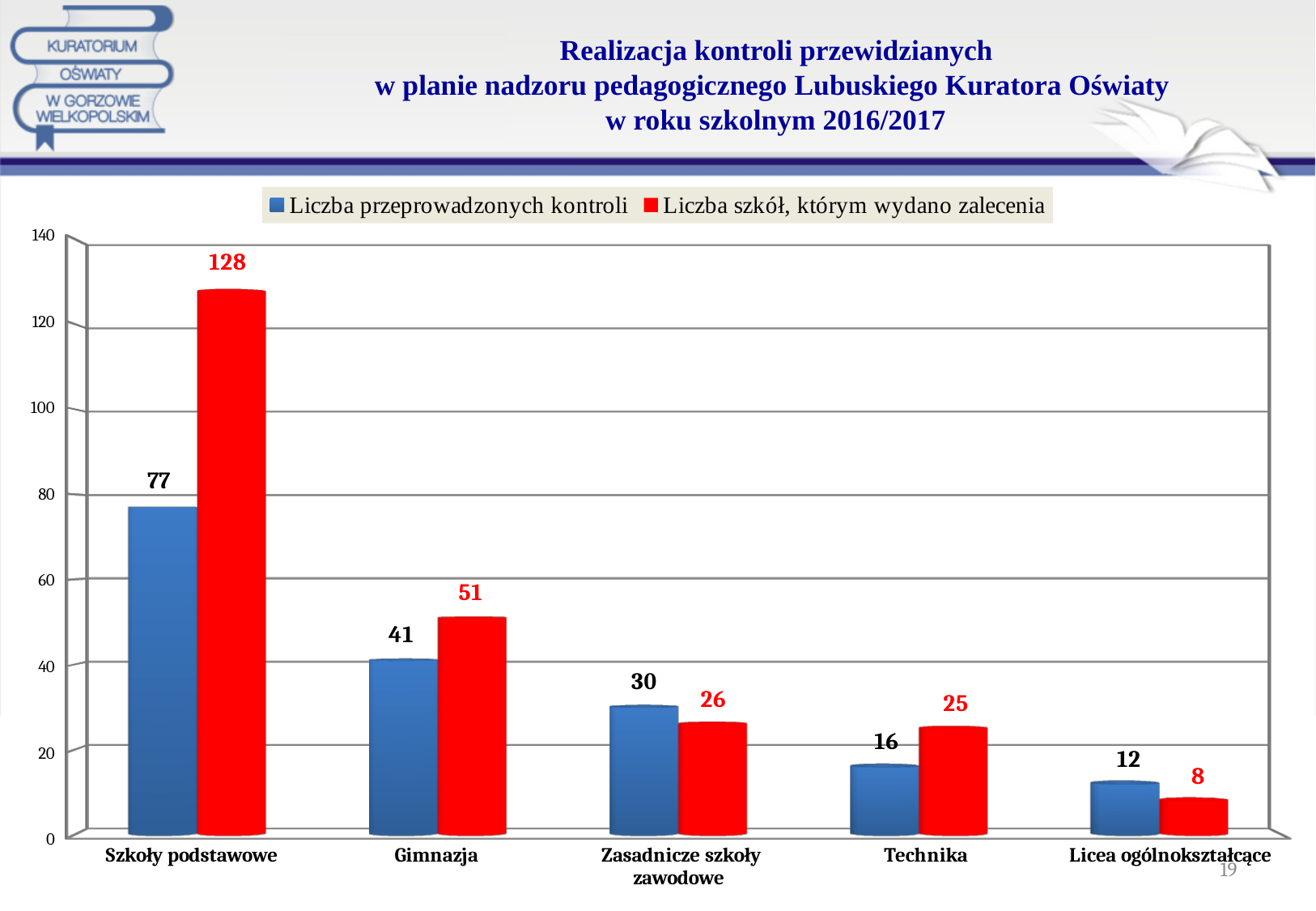
For Technika, which is larger: "Liczba przeprowadzonych kontroli" or "Liczba szkół, którym wydano zalecenia"? Liczba szkół, którym wydano zalecenia Which category has the lowest value for "Liczba przeprowadzonych kontroli"? Licea ogólnokształcące What is the value of "Liczba przeprowadzonych kontroli" for Szkoły podstawowe? 77 What is the value of "Liczba szkół, którym wydano zalecenia" for Licea ogólnokształcące? 8 What kind of chart is shown on the slide? bar chart What is the value of "Liczba szkół, którym wydano zalecenia" for Gimnazja? 51 Is the value of "Liczba przeprowadzonych kontroli" for Gimnazja greater or less than 40? greater How many categories are shown on the x axis? 5 How many series does the legend list? 2 What colour are the bars for "Liczba szkół, którym wydano zalecenia"? red What is the difference between "Liczba szkół, którym wydano zalecenia" and "Liczba przeprowadzonych kontroli" for Szkoły podstawowe? 51 Which category has the highest value for "Liczba szkół, którym wydano zalecenia"? Szkoły podstawowe